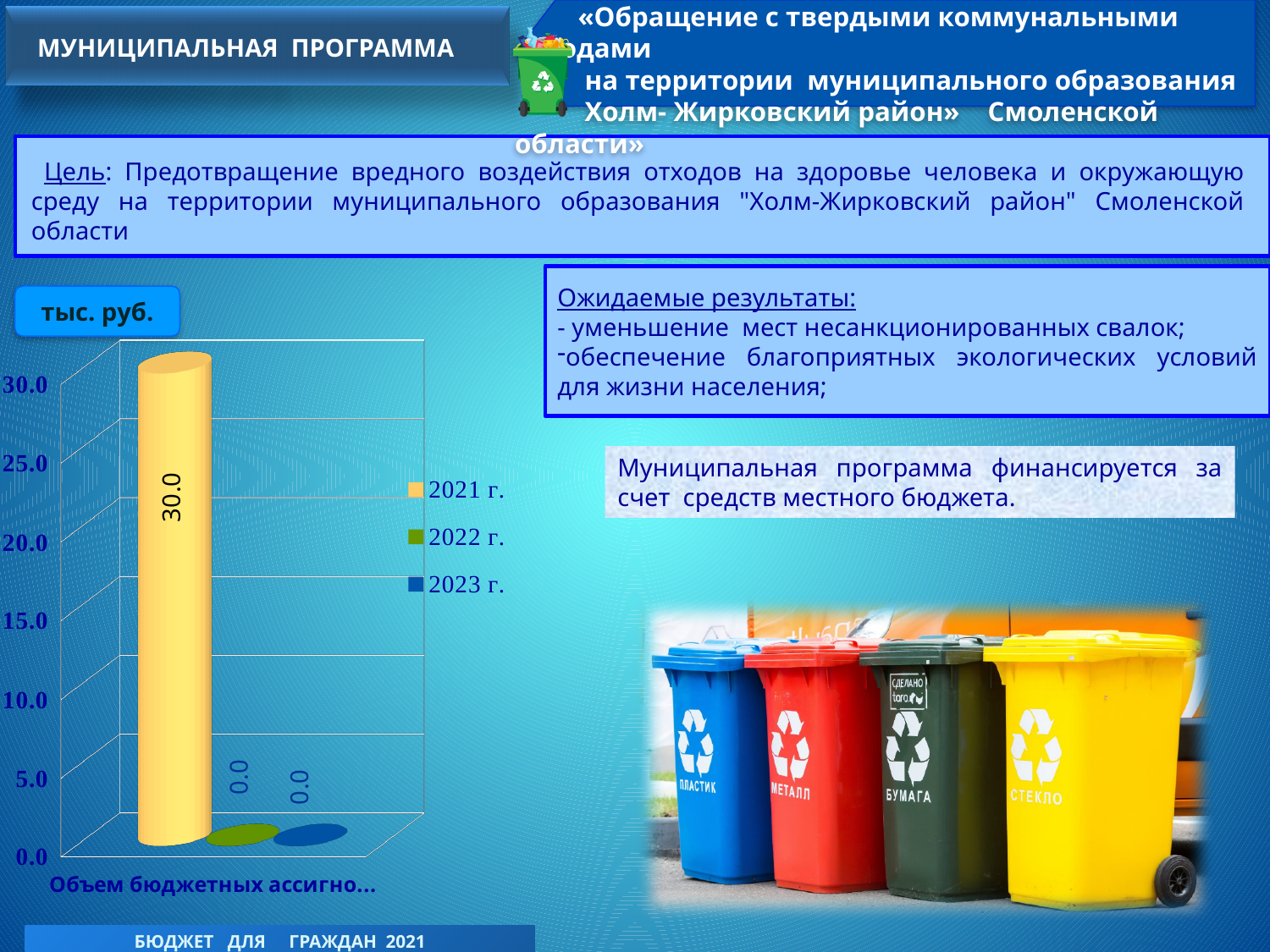
What is the value for 2022 г. in the chart? 0.0 What is the difference between the values for 2021 г. and 2022 г.? 30.0 What unit of measurement is indicated for the chart values? тыс. руб. What is the highest tick value shown on the vertical axis of the chart? 30.0 Is the value for 2021 г. greater or less than 25.0? greater Which is larger, the value for 2021 г. or the value for 2023 г.? 2021 г. What is the total of the values for 2021 г., 2022 г. and 2023 г.? 30.0 What is the value for 2023 г. in the chart? 0.0 What kind of chart is shown on the slide? bar chart Which year has the highest value in the chart? 2021 г. How many series does the chart legend list? 3 What is the value for 2021 г. in the chart? 30.0